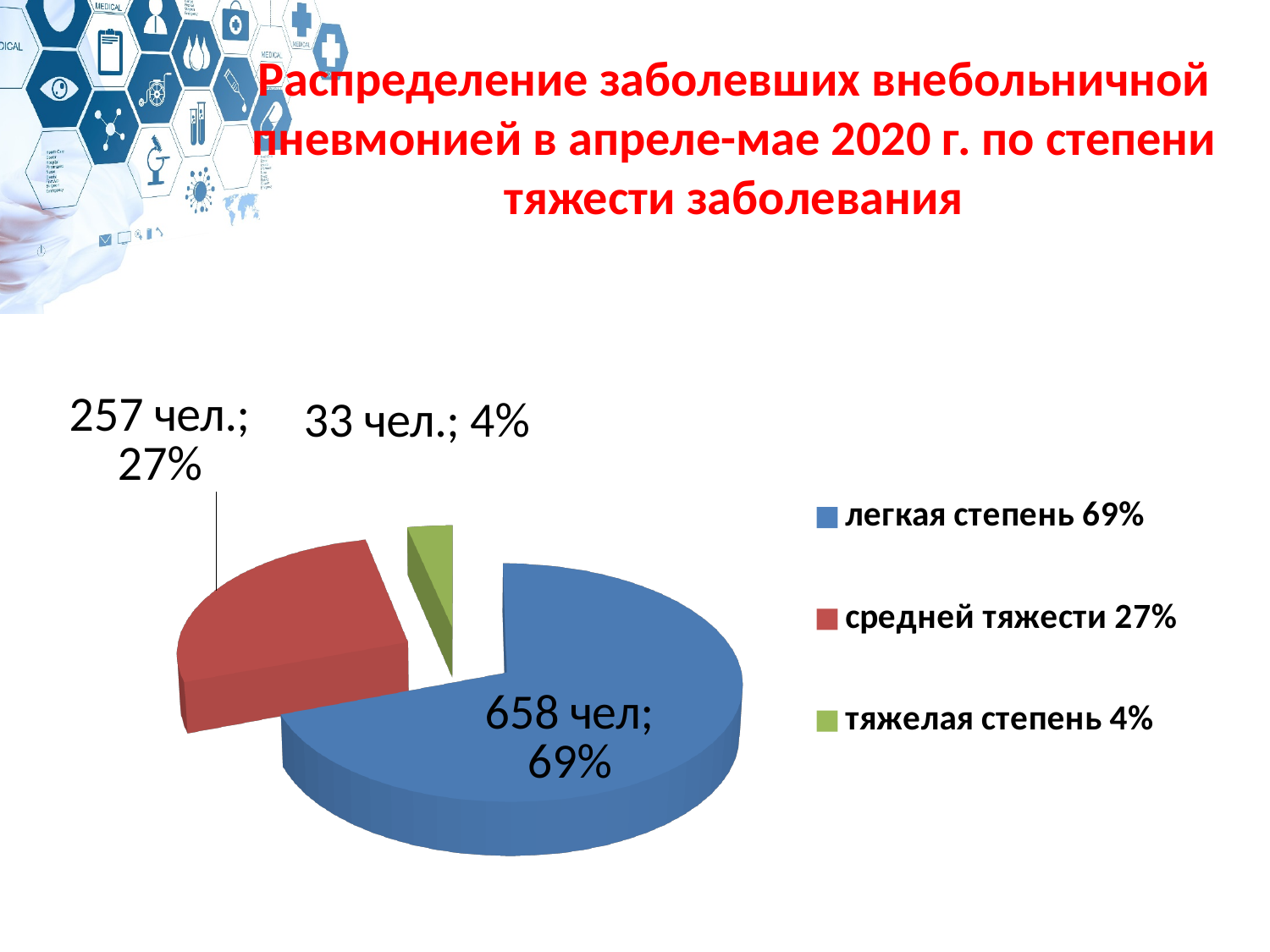
Which category has the largest slice? легкая степень Which category has the smallest slice? тяжелая степень How many people are in the 'легкая степень' category? 658 чел How many slices does the pie chart have? 3 How many entries does the legend list? 3 What share of the pie does 'тяжелая степень' represent? 4% What kind of chart is shown on the slide? pie chart What is the difference in number of people between 'легкая степень' and 'средней тяжести'? 401 Which colour represents 'средней тяжести' in the chart? red How many people are in the 'средней тяжести' category? 257 чел. How many people are in the 'тяжелая степень' category? 33 чел. What share of the pie does 'средней тяжести' represent? 27%